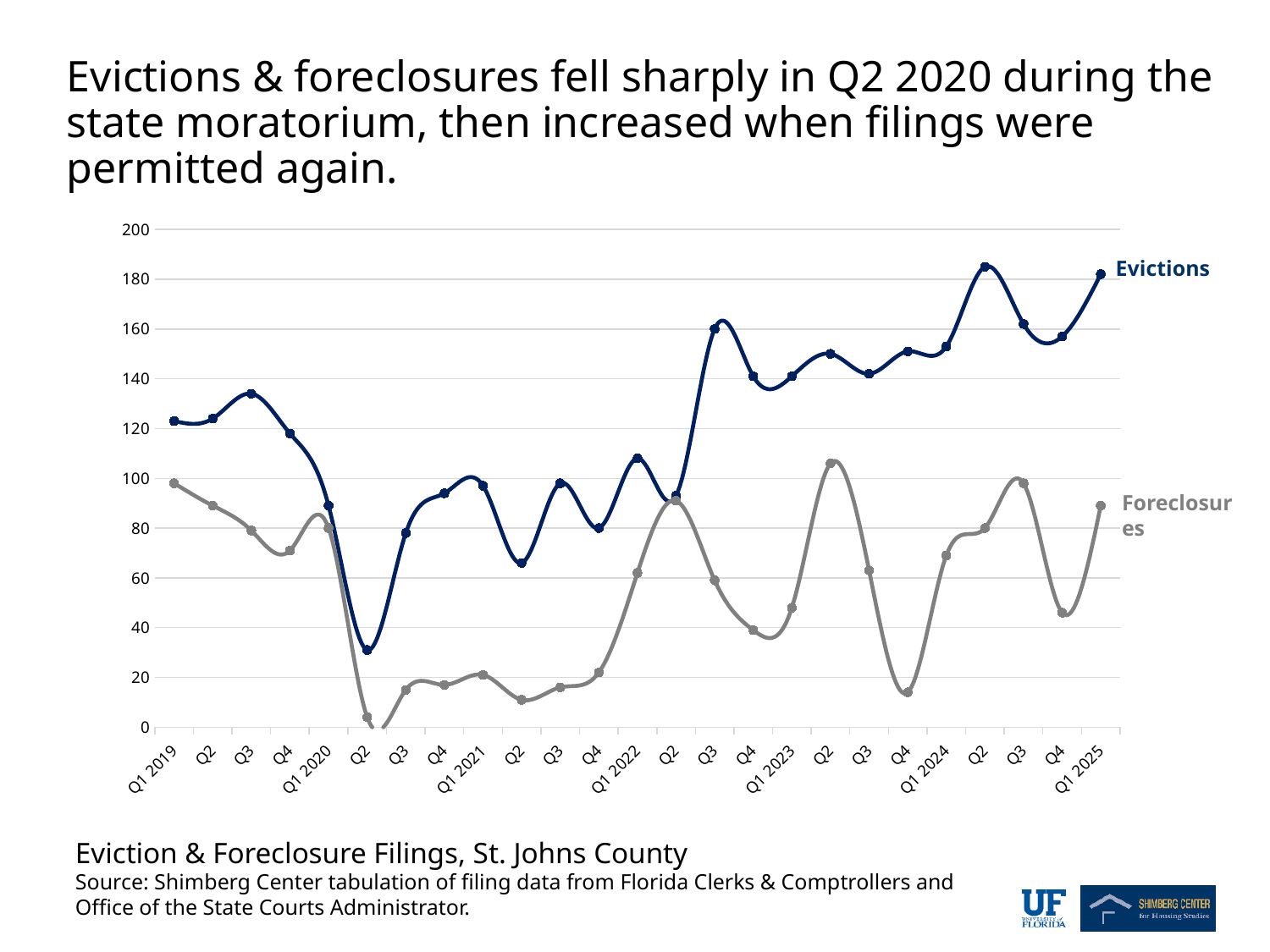
Is the value for Evictions in Q2 2020 greater or less than 40? less How many quarterly data points does each line have, from Q1 2019 to Q1 2025? 25 Is the value for Foreclosures in Q2 2023 greater or less than 100? greater In which quarter is the Foreclosures line at its lowest? Q2 2020 How many series does the chart show? 2 In which quarter is the Evictions line at its highest? Q2 2024 Do Evictions rise or fall from Q3 2019 to Q2 2020? Fall Is the value for Evictions in Q2 2024 greater or less than 180? greater In Q1 2025, which series has the larger value, Evictions or Foreclosures? Evictions What kind of chart is shown on the slide? Line chart In which quarter is the Evictions line at its lowest? Q2 2020